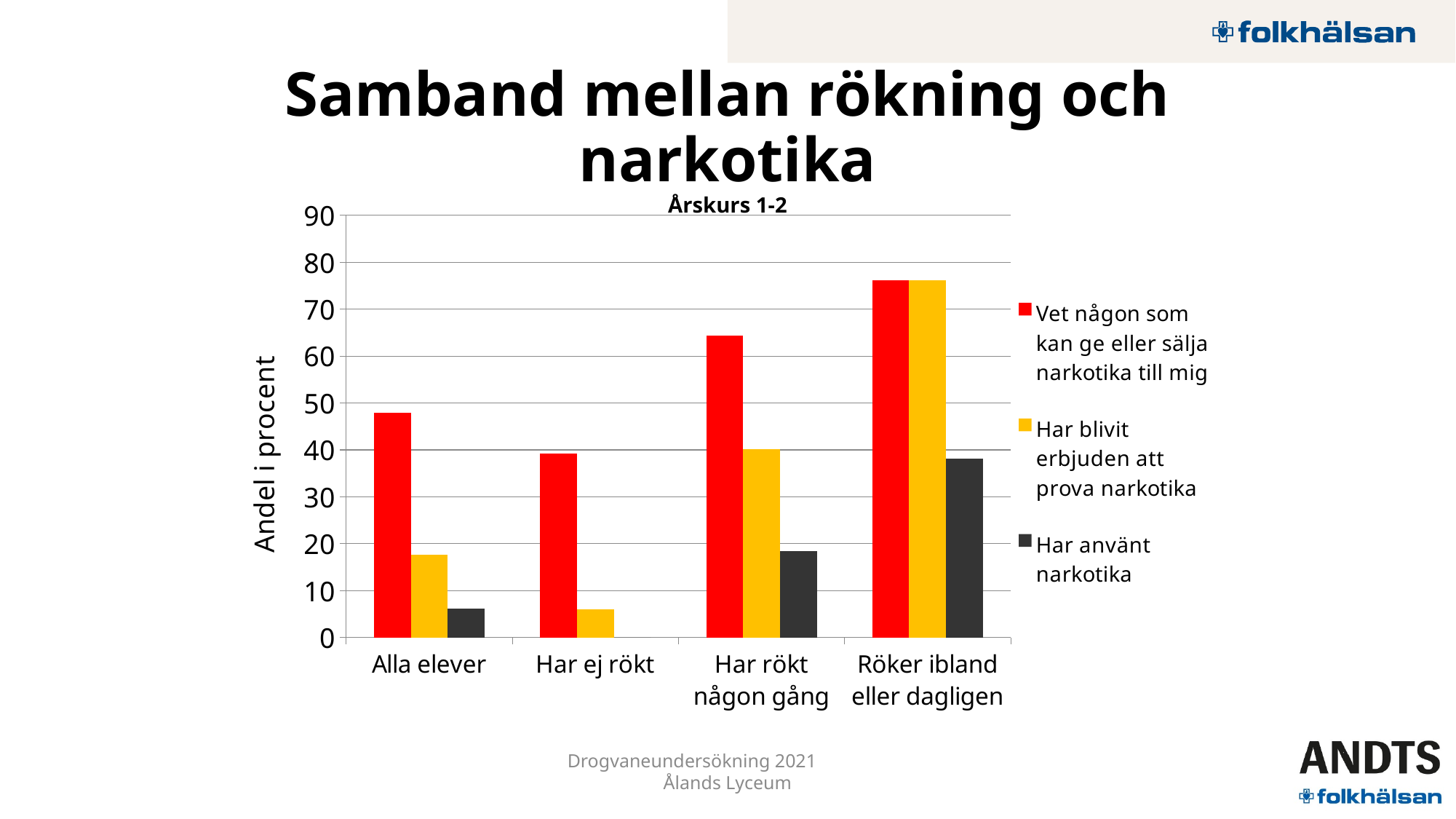
Which category has the lowest value for 'Vet någon som kan ge eller sälja narkotika till mig'? Har ej rökt Is the value for 'Vet någon som kan ge eller sälja narkotika till mig' in the 'Röker ibland eller dagligen' category greater or less than 70? greater Which category has the highest value for 'Vet någon som kan ge eller sälja narkotika till mig'? Röker ibland eller dagligen Is the value for 'Vet någon som kan ge eller sälja narkotika till mig' in the 'Alla elever' category greater or less than 40? greater Which is larger: the value for 'Har blivit erbjuden att prova narkotika' in 'Har rökt någon gång' or in 'Har ej rökt'? Har rökt någon gång How many categories are shown on the x axis of the chart? 4 Does the value for 'Vet någon som kan ge eller sälja narkotika till mig' rise or fall from 'Har ej rökt' to 'Röker ibland eller dagligen'? rise How many series does the chart's legend list? 3 Which category has the highest value for 'Har använt narkotika'? Röker ibland eller dagligen What is the label on the chart's vertical axis? Andel i procent Is the value for 'Har använt narkotika' in the 'Alla elever' category greater or less than 10? less What kind of chart is shown on the slide? bar chart